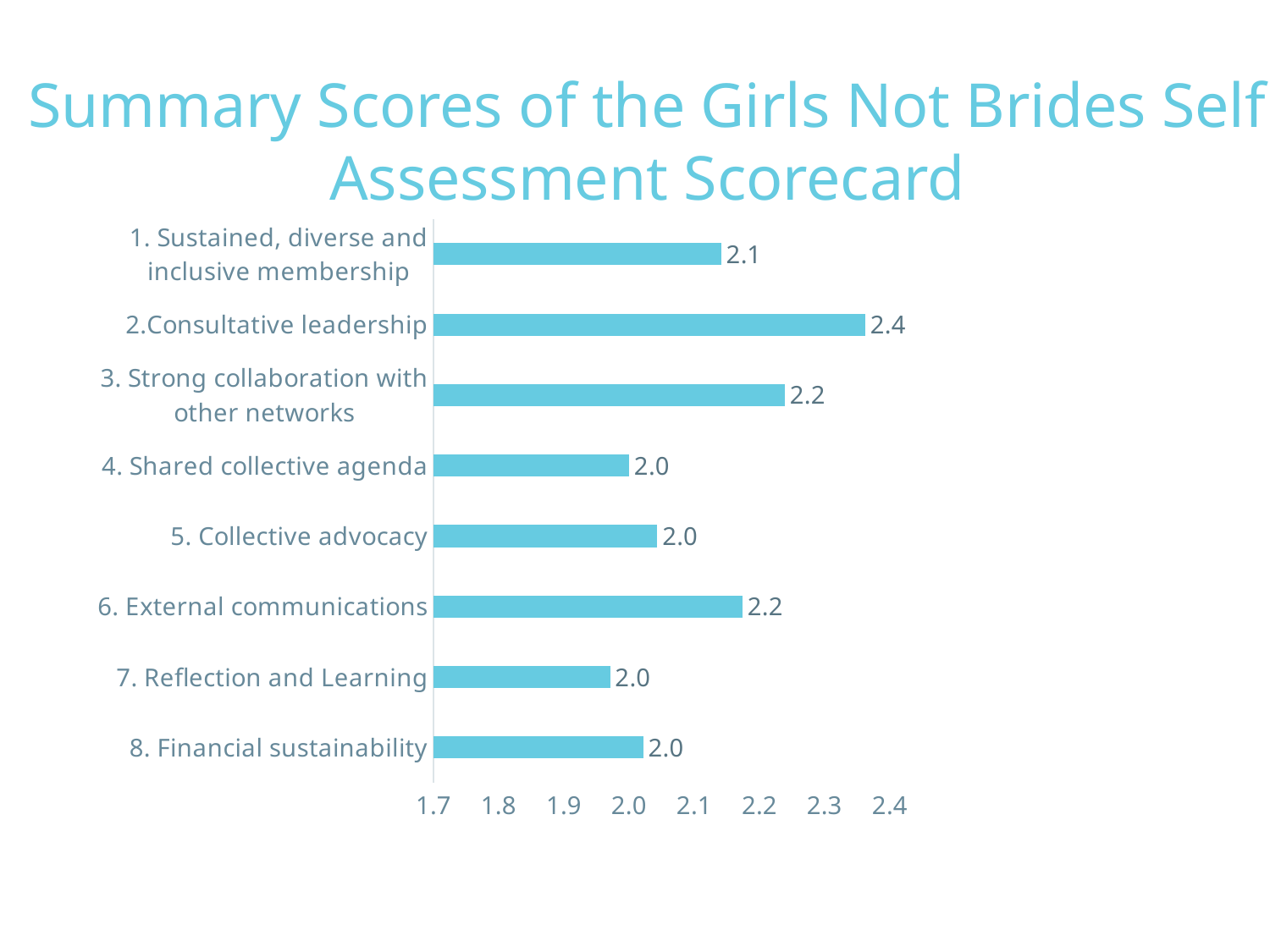
Which has a higher score, 2.Consultative leadership or 4. Shared collective agenda? 2.Consultative leadership What is the score for 6. External communications? 2.2 What is the score for 3. Strong collaboration with other networks? 2.2 What is the score for 1. Sustained, diverse and inclusive membership? 2.1 What is the title of the chart? Summary Scores of the Girls Not Brides Self Assessment Scorecard Is the value for 2.Consultative leadership greater or less than 2.3? greater What is the score for 2.Consultative leadership? 2.4 What is the difference between the scores for 2.Consultative leadership and 1. Sustained, diverse and inclusive membership? 0.3 What is the score for 8. Financial sustainability? 2.0 How many categories are shown in the chart? 8 Which category has the highest score? 2.Consultative leadership What kind of chart is shown on the slide? Bar chart